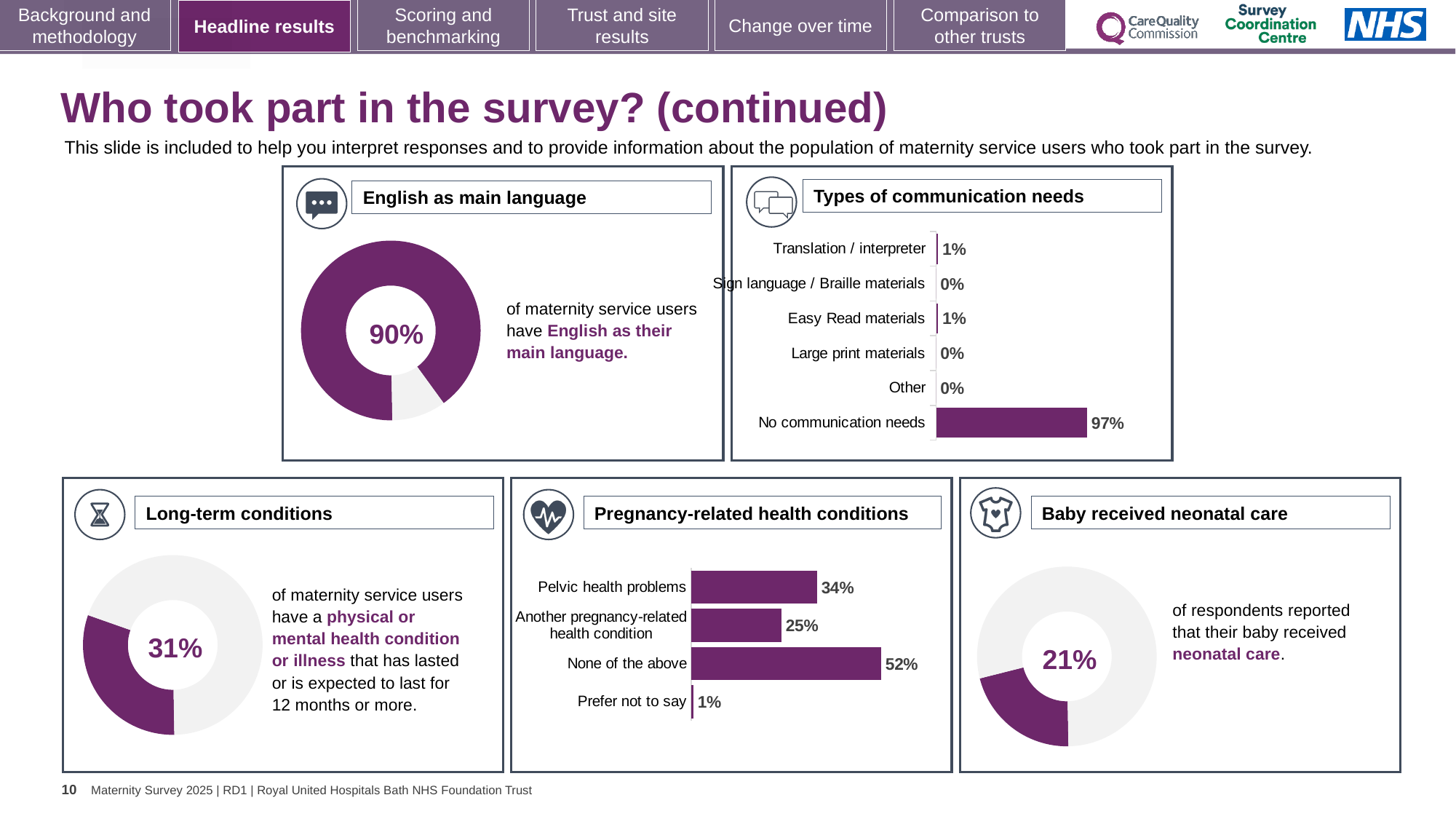
What kind of chart is used in the 'English as main language' panel? Doughnut chart In the 'Types of communication needs' chart, which category has the highest value? No communication needs In the 'Types of communication needs' chart, what is the value for 'Translation / interpreter'? 1% In the 'Pregnancy-related health conditions' chart, what is the value for 'Another pregnancy-related health condition'? 25% In the 'Baby received neonatal care' chart, what percentage of respondents reported that their baby received neonatal care? 21% In the 'Pregnancy-related health conditions' chart, which category has the lowest value? Prefer not to say In the 'Pregnancy-related health conditions' chart, what is the value for 'Pelvic health problems'? 34% How many categories are shown in the 'Types of communication needs' chart? 6 In the 'Types of communication needs' chart, what is the value for 'No communication needs'? 97% In the 'Pregnancy-related health conditions' chart, which is larger: 'Pelvic health problems' or 'Another pregnancy-related health condition'? Pelvic health problems In the 'Pregnancy-related health conditions' chart, what is the difference between 'None of the above' and 'Pelvic health problems'? 18% In the 'Pregnancy-related health conditions' chart, which category has the highest value? None of the above